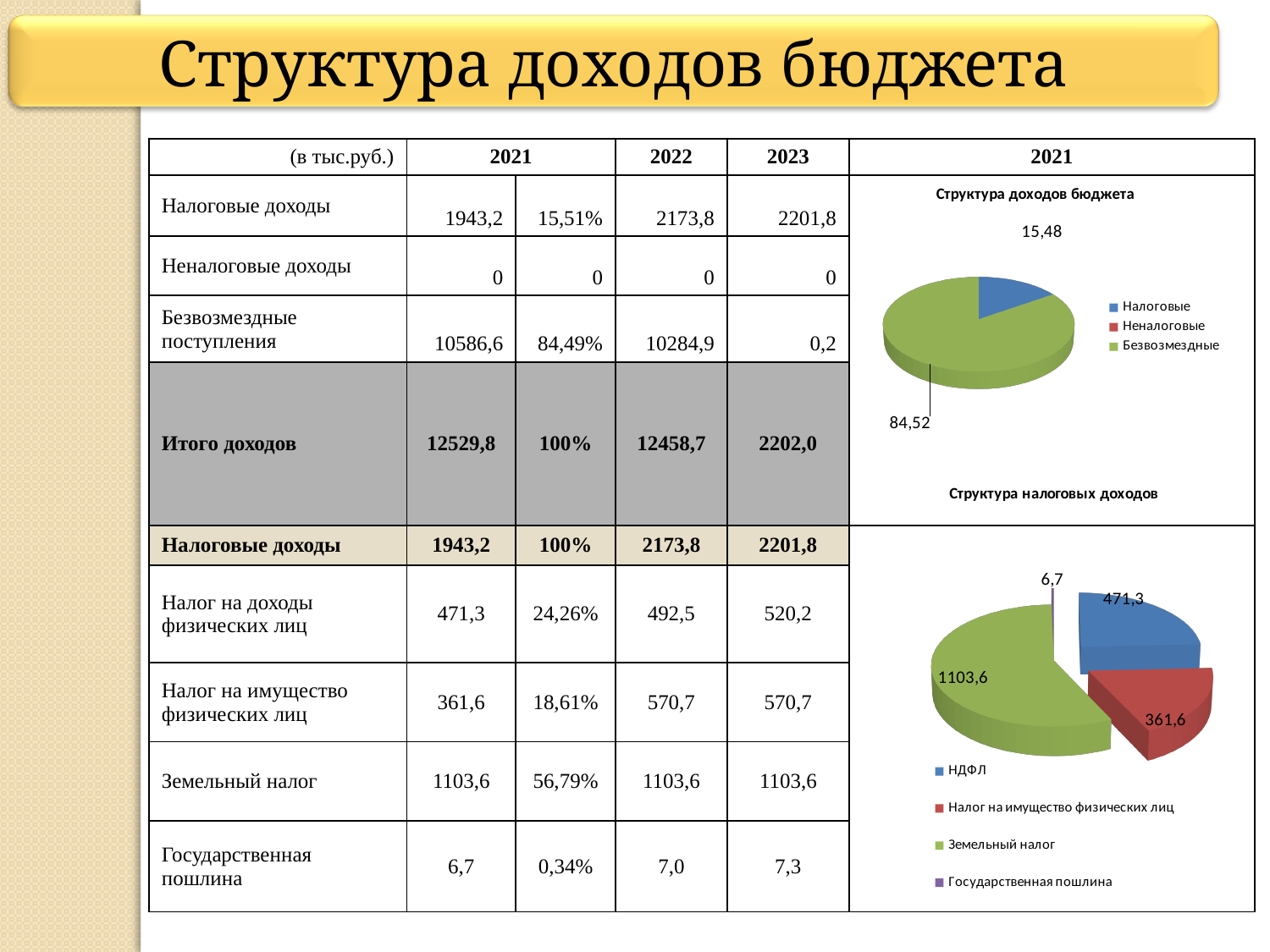
In the chart titled «Структура налоговых доходов», which category has the smallest slice? Государственная пошлина In the chart titled «Структура доходов бюджета», what value is shown for the «Безвозмездные» slice? 84,52 In the chart titled «Структура налоговых доходов», how many entries does the legend list? 4 In the chart titled «Структура доходов бюджета», which category has the largest slice? Безвозмездные In the chart titled «Структура налоговых доходов», what value is shown for «Земельный налог»? 1103,6 In the chart titled «Структура доходов бюджета», what value is shown for the «Налоговые» slice? 15,48 In the chart titled «Структура доходов бюджета», how many entries does the legend list? 3 In the chart titled «Структура налоговых доходов», what is the difference between «НДФЛ» (471,3) and «Налог на имущество физических лиц» (361,6)? 109,7 In the chart titled «Структура налоговых доходов», what value is shown for «НДФЛ»? 471,3 In the chart titled «Структура налоговых доходов», what value is shown for «Государственная пошлина»? 6,7 What kind of chart is the chart titled «Структура доходов бюджета»? pie chart In the chart titled «Структура налоговых доходов», which is larger: «НДФЛ» or «Налог на имущество физических лиц»? НДФЛ